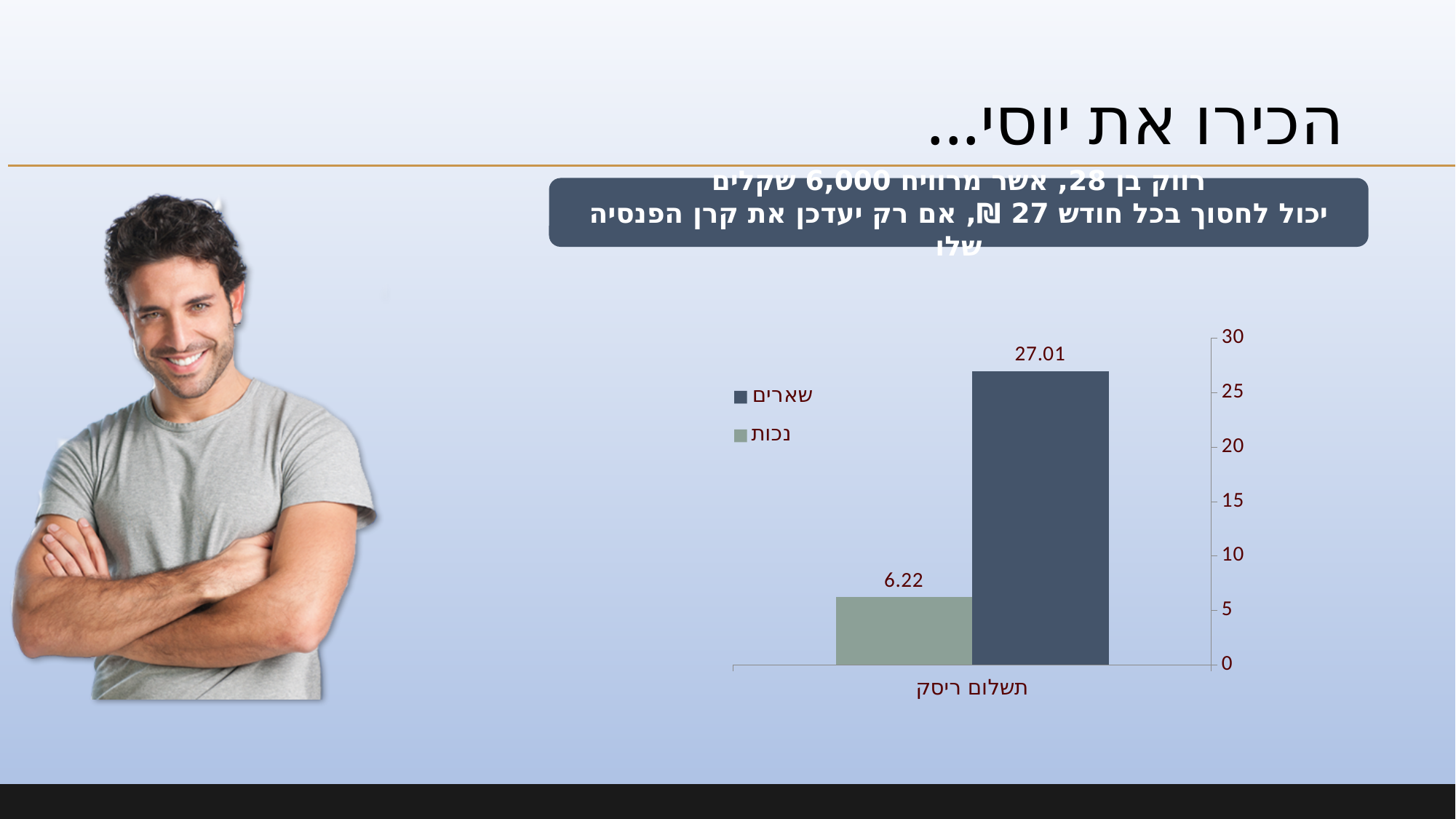
What is the difference between the שארים value and the נכות value for תשלום ריסק? 20.79 What is the category label shown on the x axis of the chart? תשלום ריסק What is the value of the שארים bar for תשלום ריסק? 27.01 Which series has the higher value for תשלום ריסק, שארים or נכות? שארים Is the value of the שארים bar greater or less than 25? greater How many categories are shown on the x axis of the chart? 1 Is the value of the נכות bar greater or less than 10? less Which series has the lowest value in the chart? נכות What is the value of the נכות bar for תשלום ריסק? 6.22 Which series has the highest value in the chart? שארים How many series does the legend list? 2 What kind of chart is shown on the slide? bar chart